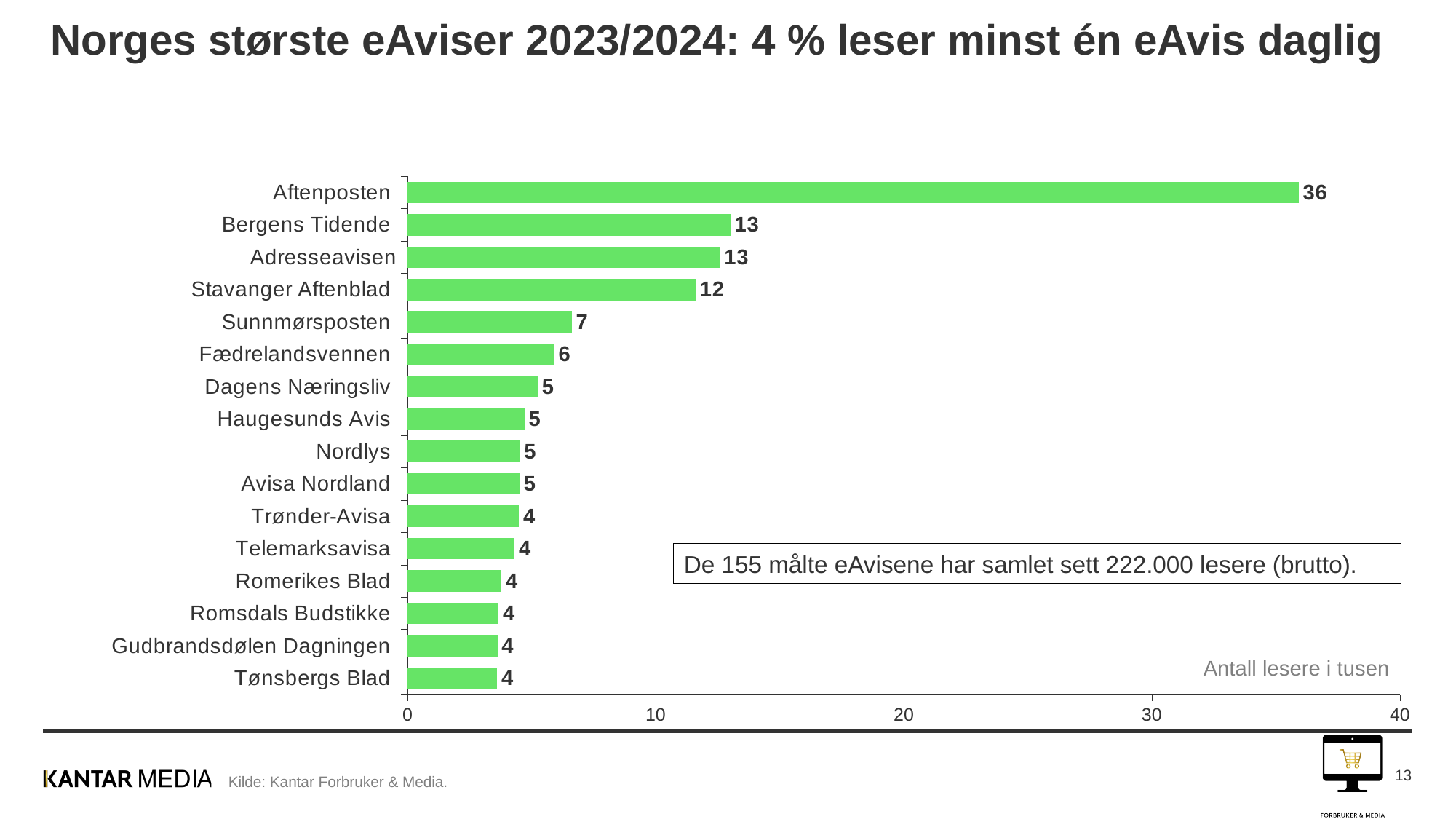
What is the value for Stavanger Aftenblad? 12 What is the value for Sunnmørsposten? 7 What unit label is shown for the values in the chart? Antall lesere i tusen What is the value for Aftenposten? 36 What kind of chart is shown on the slide? bar chart Is the value for Aftenposten greater or less than 30? greater What is the difference between the values for Aftenposten and Bergens Tidende? 23 Which newspaper has the highest value? Aftenposten How many newspapers are shown in the chart? 16 What is the value for Fædrelandsvennen? 6 What is the difference between the values for Stavanger Aftenblad and Sunnmørsposten? 5 Which is larger, the value for Sunnmørsposten or the value for Dagens Næringsliv? Sunnmørsposten